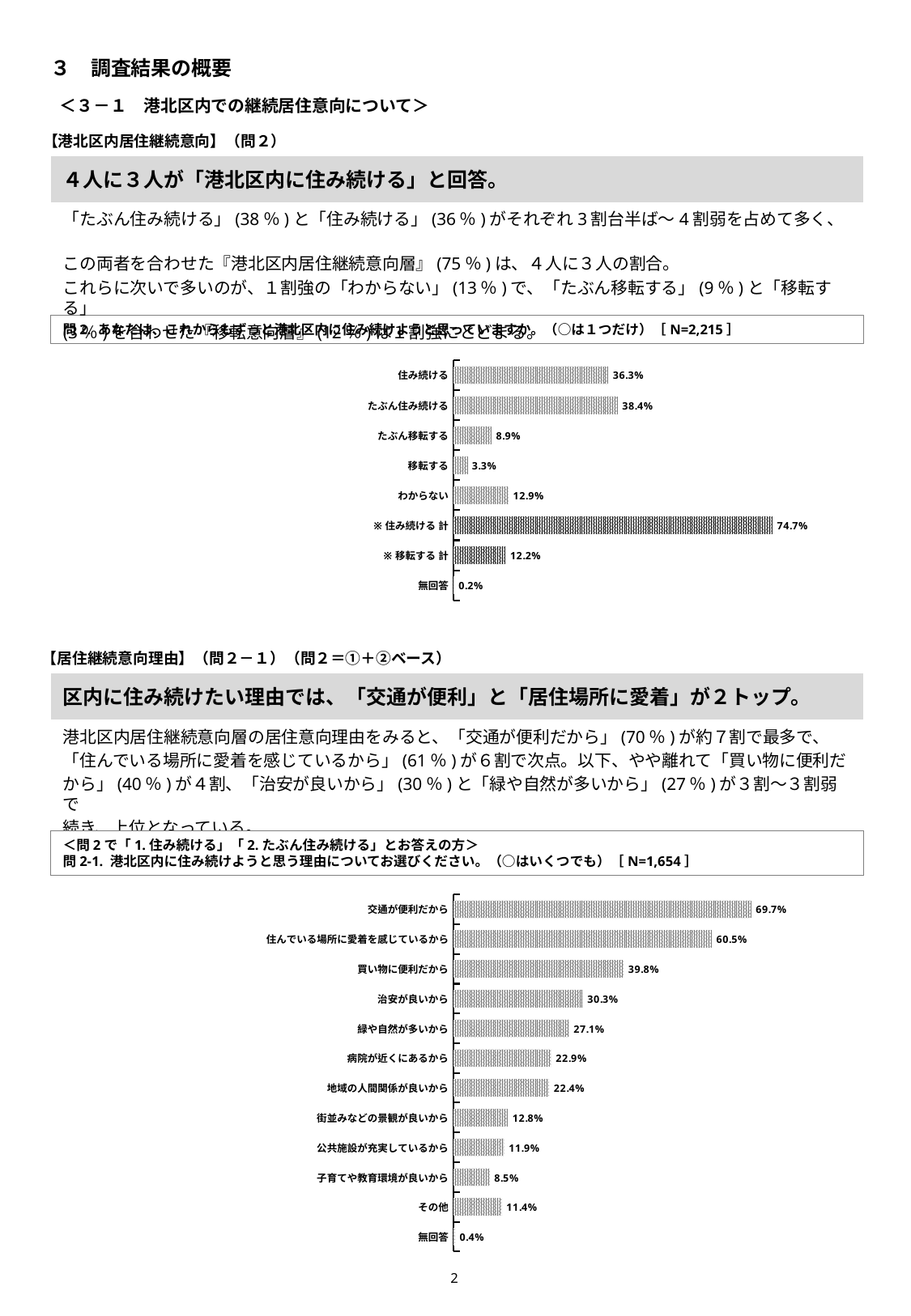
In the top chart (問2, 港北区内居住継続意向), what is the value for 「たぶん住み続ける」? 38.4% How many categories are shown in the bottom chart (問2-1)? 12 How many categories are shown in the top chart (問2)? 8 In the top chart (問2), which category has the lowest value? 無回答 In the top chart (問2), which is larger, 「たぶん移転する」 or 「移転する」? たぶん移転する In the top chart (問2), what is the difference between 「たぶん住み続ける」 and 「住み続ける」? 2.1% In the bottom chart (問2-1), what is the value for 「交通が便利だから」? 69.7% In the top chart (問2), what is the value for 「わからない」? 12.9% In the bottom chart (問2-1), what is the value for 「治安が良いから」? 30.3% In the bottom chart (問2-1), what is the difference between 「交通が便利だから」 and 「住んでいる場所に愛着を感じているから」? 9.2% In the bottom chart (問2-1), which category has the highest value? 交通が便利だから What kind of chart is the bottom chart (問2-1)? Bar chart